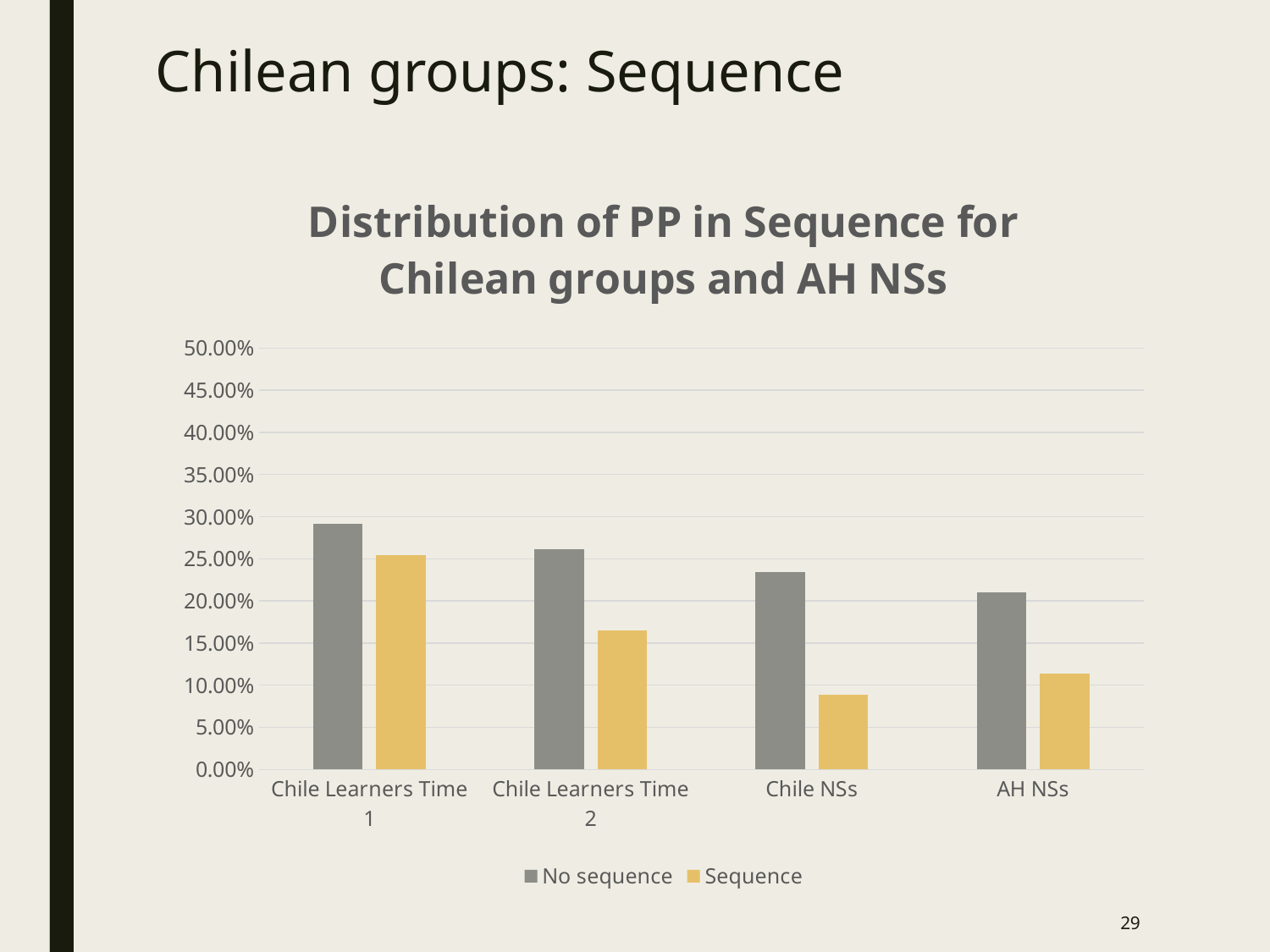
Is the 'No sequence' value for Chile NSs greater or less than 20.00%? greater What is the title of the chart? Distribution of PP in Sequence for Chilean groups and AH NSs How many series does the legend list? 2 Is the 'No sequence' value for Chile Learners Time 1 greater or less than 25.00%? greater For Chile Learners Time 2, which is larger: 'No sequence' or 'Sequence'? No sequence Which group has the lowest 'Sequence' value? Chile NSs Which group has the lowest 'No sequence' value? AH NSs What kind of chart is shown on the slide? bar chart How many groups (categories) are shown on the x axis? 4 Is the 'Sequence' value for AH NSs greater or less than 15.00%? less Does the 'No sequence' series rise or fall from Chile Learners Time 1 to AH NSs? fall Which group has the highest 'No sequence' value? Chile Learners Time 1